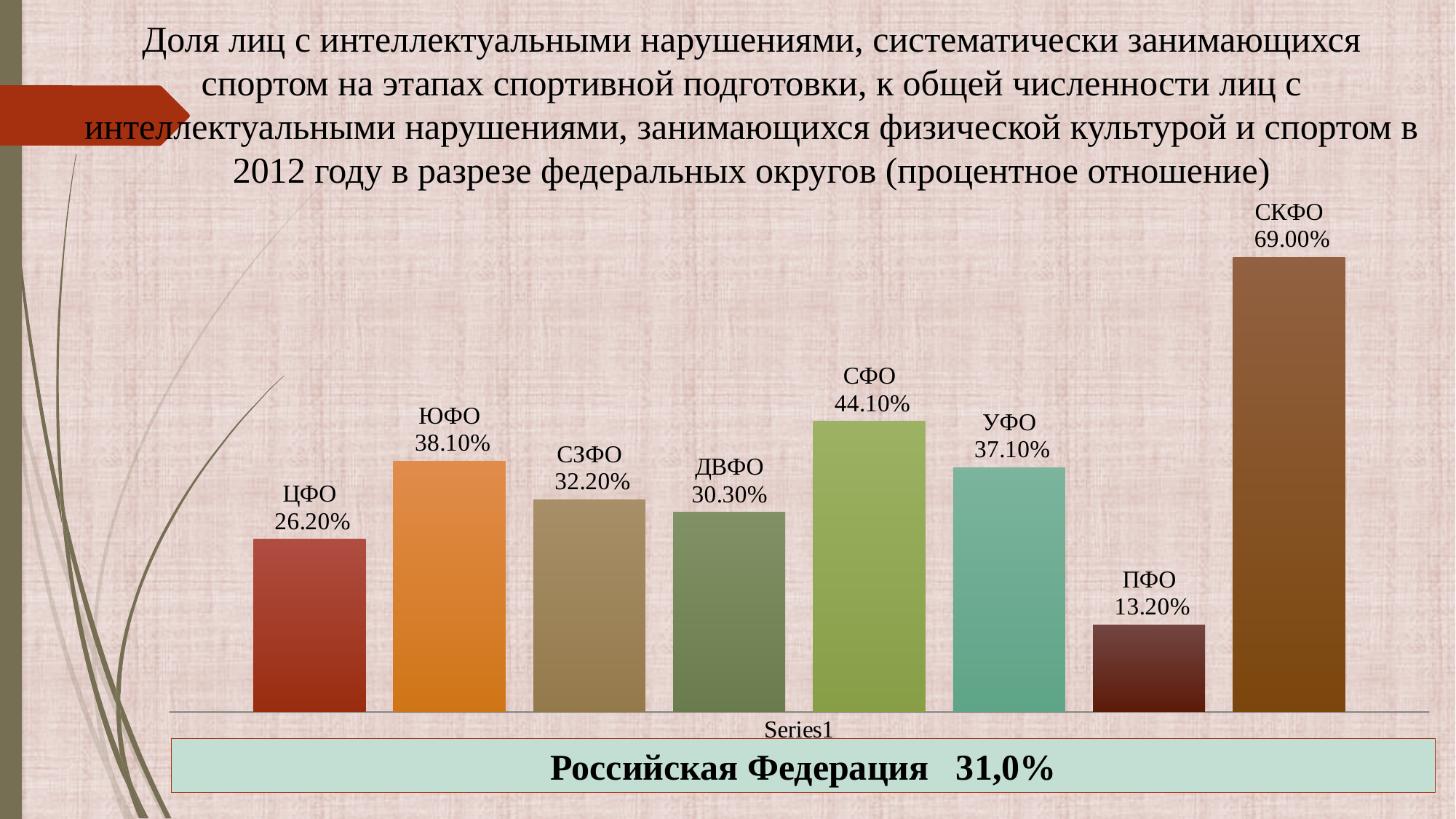
What is the difference between the values for ЮФО and ЦФО? 11.90% How many federal districts (bars) are shown on the chart? 8 Which federal district has the lowest value on the chart? ПФО What is the value shown for СКФО? 69.00% Which is larger, the value for ДВФО or the value for ЦФО? ДВФО Which is larger, the value for УФО or the value for СЗФО? УФО Which federal district has the highest value on the chart? СКФО What is the value shown for ДВФО? 30.30% What is the difference between the values for СКФО and СФО? 24.90% What is the value shown for ПФО? 13.20% What value is given for the Российская Федерация in the box below the chart? 31,0% What kind of chart is shown on the slide? Bar chart